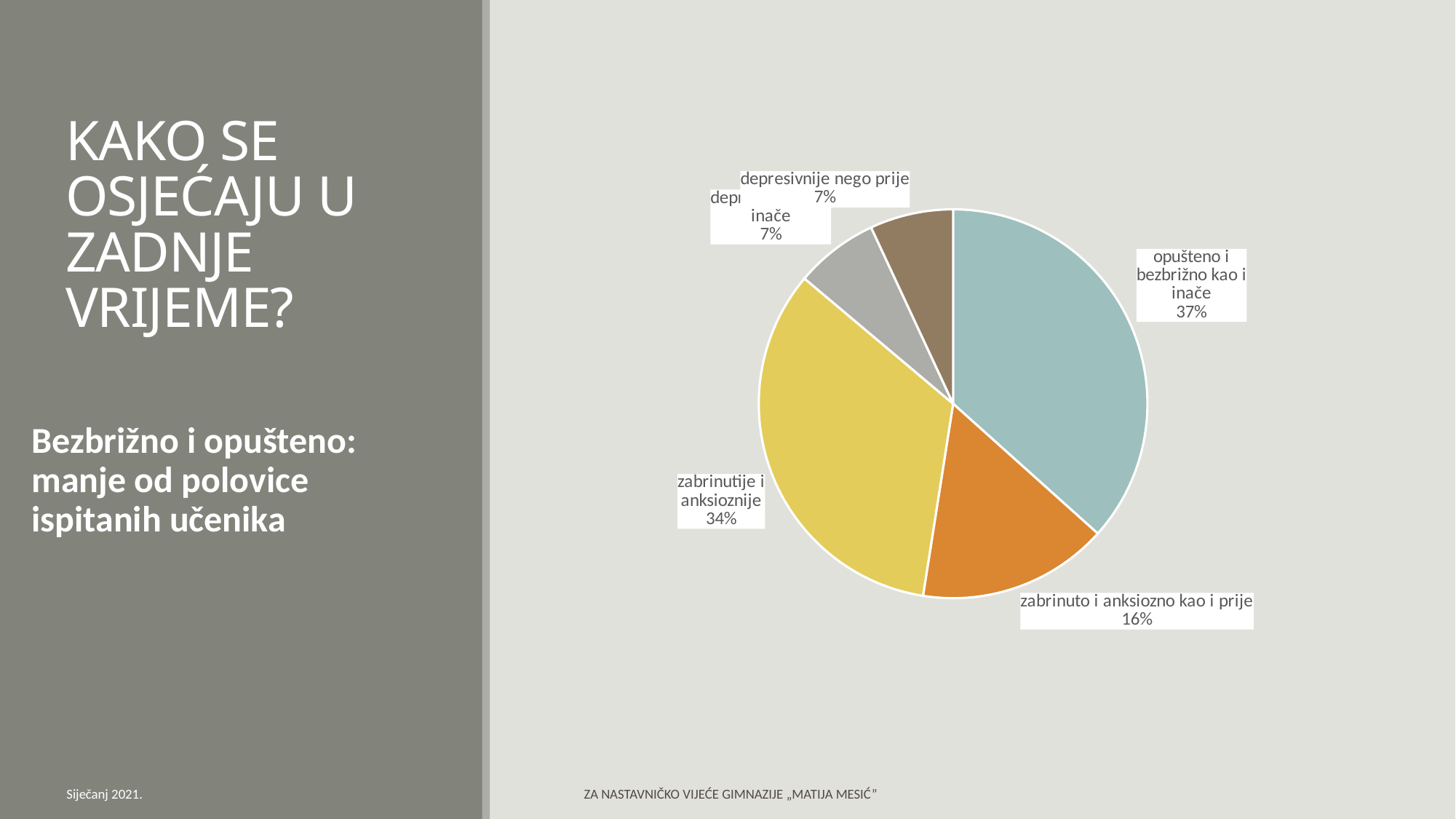
What is the difference in percentage points between "zabrinutije i anksioznije" and "zabrinuto i anksiozno kao i prije"? 18 What percentage of students answered "zabrinuto i anksiozno kao i prije"? 16% What colour is the slice for "zabrinutije i anksioznije"? yellow How many slices does the pie chart have? 5 What percentage of students answered "opušteno i bezbrižno kao i inače"? 37% What kind of chart is shown on the slide? pie chart What colour is the slice for "opušteno i bezbrižno kao i inače"? light blue-grey What percentage of students answered "zabrinutije i anksioznije"? 34% What is the difference in percentage points between "opušteno i bezbrižno kao i inače" and "zabrinutije i anksioznije"? 3 Which is larger: the share for "zabrinuto i anksiozno kao i prije" or the share for "depresivnije nego prije"? zabrinuto i anksiozno kao i prije Which category has the largest share of the pie? opušteno i bezbrižno kao i inače What percentage of students answered "depresivnije nego prije"? 7%